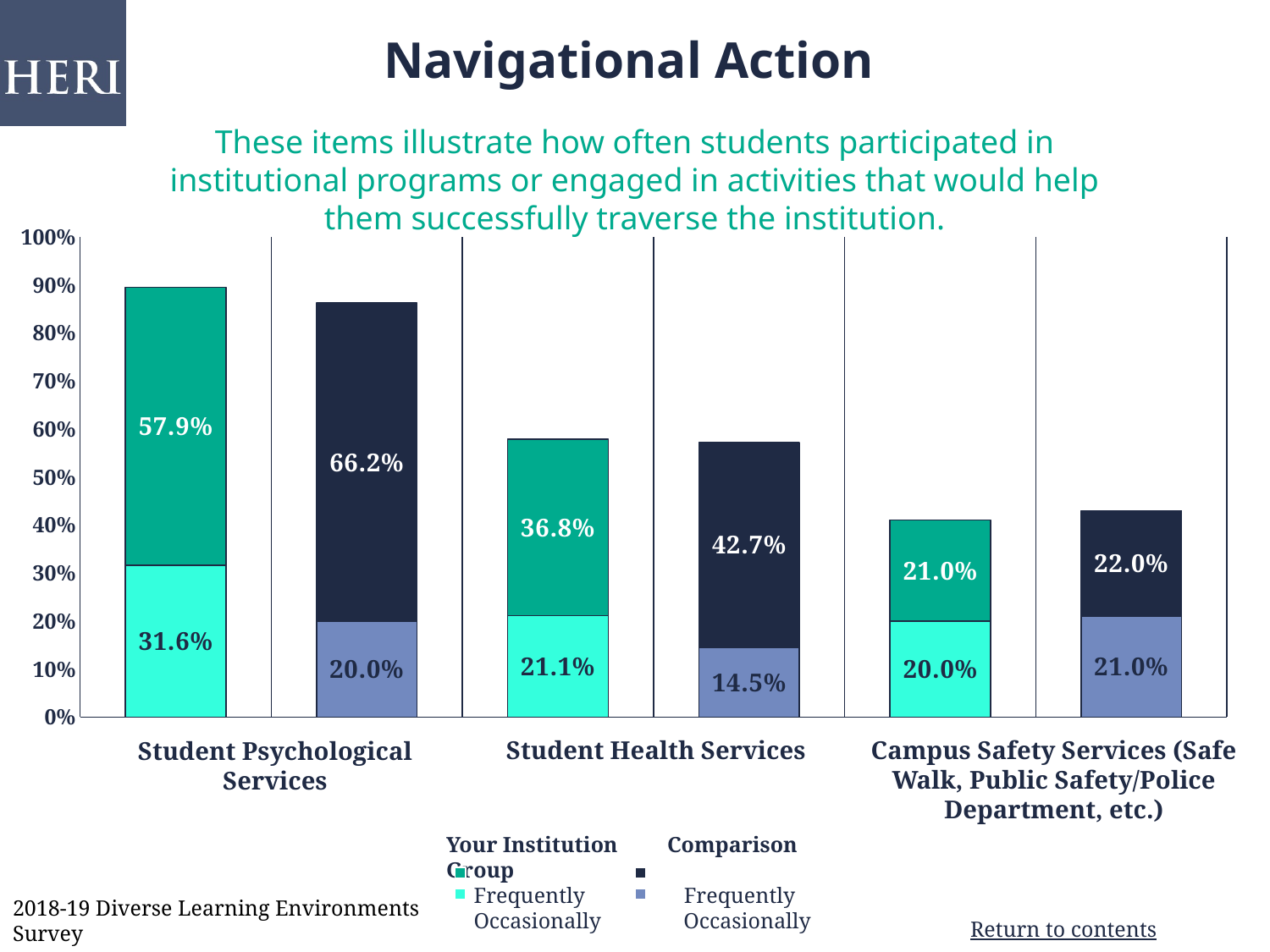
What is the 'Occasionally' value for the Comparison Group for Student Health Services? 14.5% What is the total of the Comparison Group stacked bar for Campus Safety Services? 43.0% What is the 'Frequently' value for Your Institution for Student Psychological Services? 57.9% Which is larger for Student Psychological Services: the Your Institution 'Occasionally' value or the Comparison Group 'Occasionally' value? Your Institution What is the 'Frequently' value for the Comparison Group for Campus Safety Services? 22.0% What kind of chart is shown on the slide? Stacked bar chart What is the title of the chart? Navigational Action What is the total of the Your Institution stacked bar for Student Psychological Services? 89.5% How many categories are shown along the x axis? 3 Which category has the lowest 'Frequently' value for Your Institution? Campus Safety Services (Safe Walk, Public Safety/Police Department, etc.) Is the total of the Your Institution stacked bar for Student Health Services greater or less than 50%? greater What is the difference between the Comparison Group 'Frequently' value and the Your Institution 'Frequently' value for Student Health Services? 5.9%